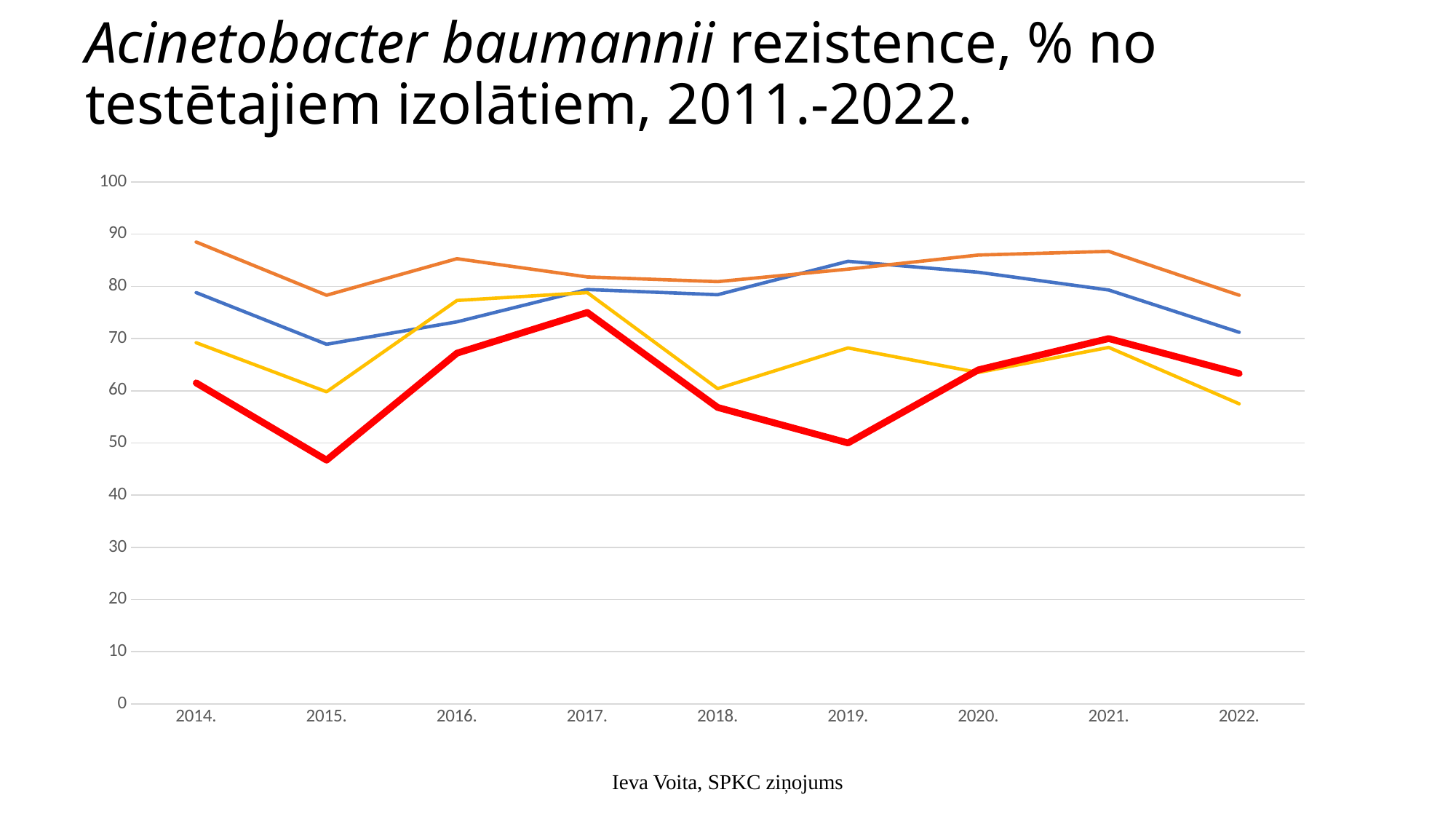
Does the thick red line rise or fall from 2014 to 2015? fall In which year does the thick red line reach its lowest value? 2015. How many years are shown on the x axis of the chart? 9 Is the value of the blue line in 2019 greater or less than 80? greater What is the first year shown on the x axis? 2014. In 2022, which line has the higher value, the blue line or the thick red line? blue line Is the value of the orange line in 2014 greater or less than 80? greater Is the value of the thick red line in 2015 greater or less than 50? less How many lines are plotted on the chart? 4 In which year does the thick red line reach its highest value? 2017. What kind of chart is shown on the slide? line chart